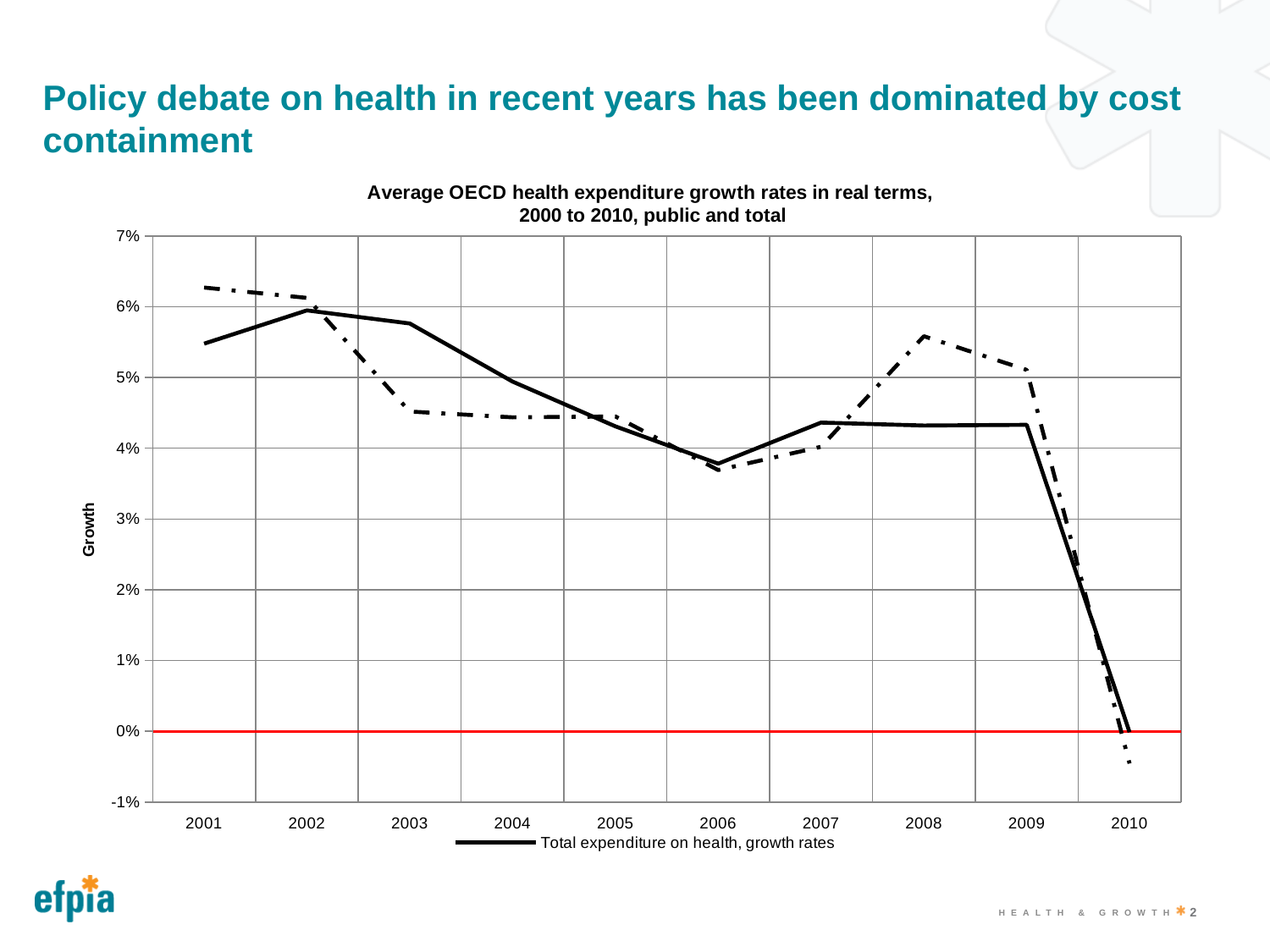
Is the value of the dashed line in 2010 greater or less than 0%? less Is the value of the dashed line in 2001 greater or less than 6%? greater How many series does the chart's legend list? 1 What kind of chart is shown on the slide? Line chart Does the solid line (Total expenditure on health, growth rates) rise or fall between 2009 and 2010? Fall In which year is the solid line (Total expenditure on health, growth rates) at its lowest? 2010 What is the title of the chart? Average OECD health expenditure growth rates in real terms, 2000 to 2010, public and total What is the label on the vertical axis of the chart? Growth Is the value of the solid line (Total expenditure on health, growth rates) in 2006 greater or less than 4%? less How many years are shown on the x axis of the chart? 10 In 2008, which line is higher, the solid line or the dashed line? The dashed line